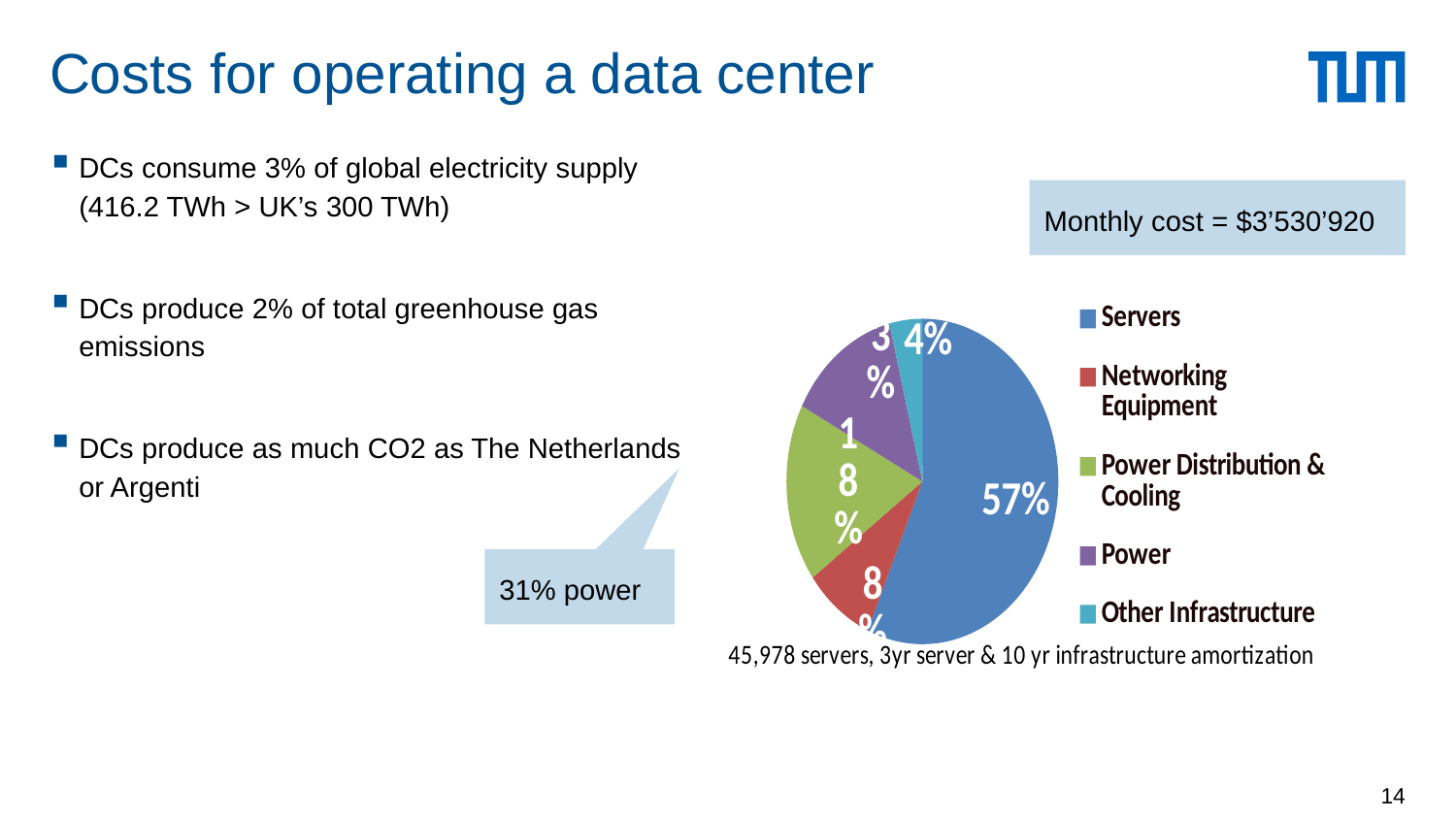
What share of the monthly cost is attributed to Other Infrastructure? 4% By how many percentage points does the Servers share exceed the Power Distribution & Cooling share? 39 percentage points What monthly cost is stated above the pie chart? $3'530'920 What share of the monthly cost is attributed to Networking Equipment? 8% Which category has the smallest slice of the pie? Other Infrastructure What share of the monthly cost is attributed to Power Distribution & Cooling? 18% How many categories does the pie chart legend list? 5 Which category has the largest slice of the pie? Servers Which is larger, the share for Networking Equipment or the share for Other Infrastructure? Networking Equipment Which is larger, the share for Servers or the share for Power Distribution & Cooling? Servers What kind of chart is shown on the slide? pie chart What share of the monthly cost is attributed to Servers? 57%